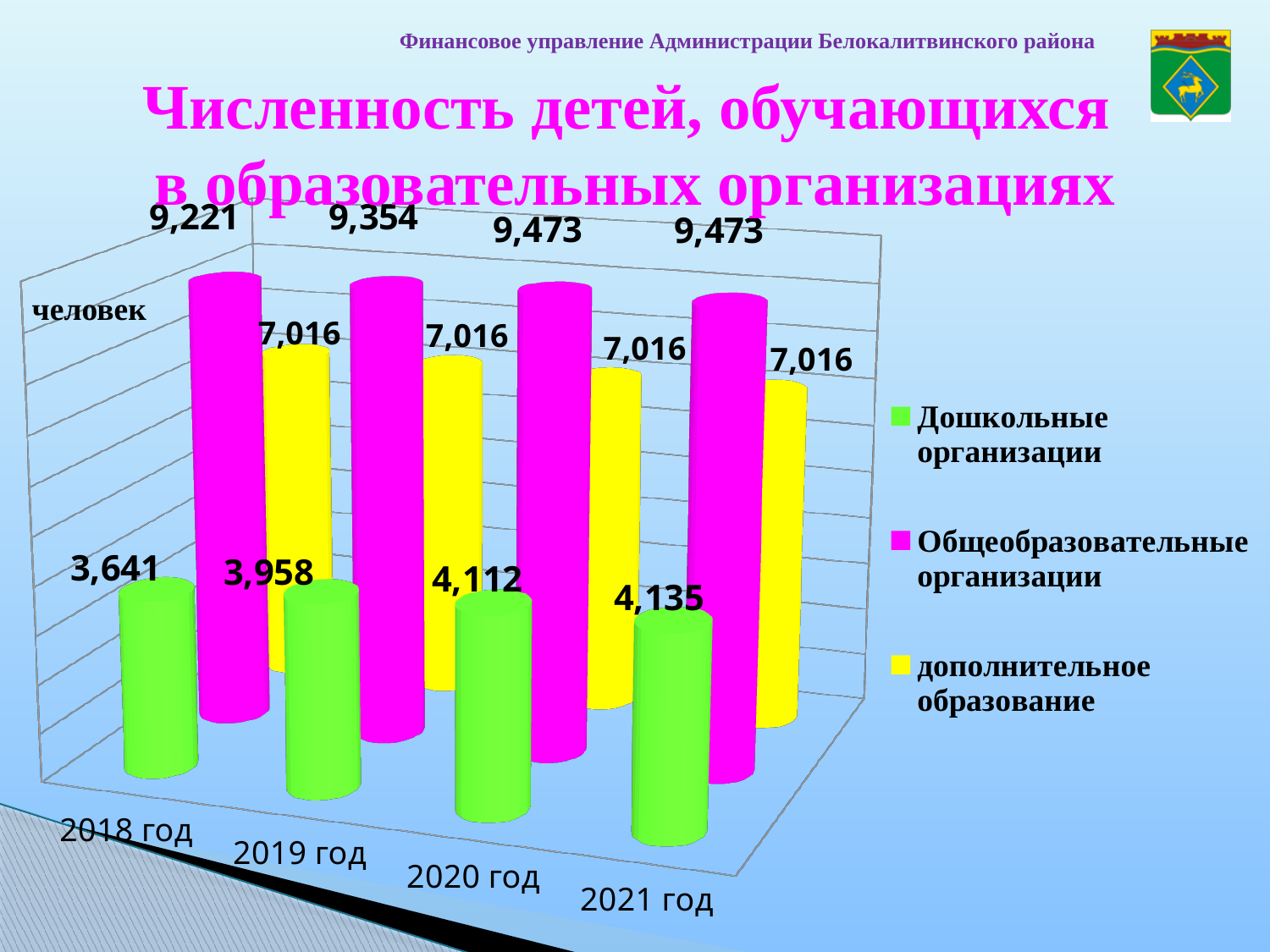
Which is larger in 2019 год: Общеобразовательные организации or дополнительное образование? Общеобразовательные организации What is the value for дополнительное образование in 2021 год? 7,016 What is the difference between the Общеобразовательные организации values for 2019 год and 2018 год? 133 In which year is the value for Общеобразовательные организации the lowest? 2018 год What is the value for Общеобразовательные организации in 2020 год? 9,473 In which year is the value for Дошкольные организации the highest? 2021 год How many years are shown on the x axis? 4 How many series does the legend list? 3 What is the value for Дошкольные организации in 2018 год? 3,641 Do the values for Дошкольные организации rise or fall from 2018 год to 2021 год? rise What is the difference between the Дошкольные организации values for 2021 год and 2018 год? 494 What kind of chart is shown on the slide? bar chart